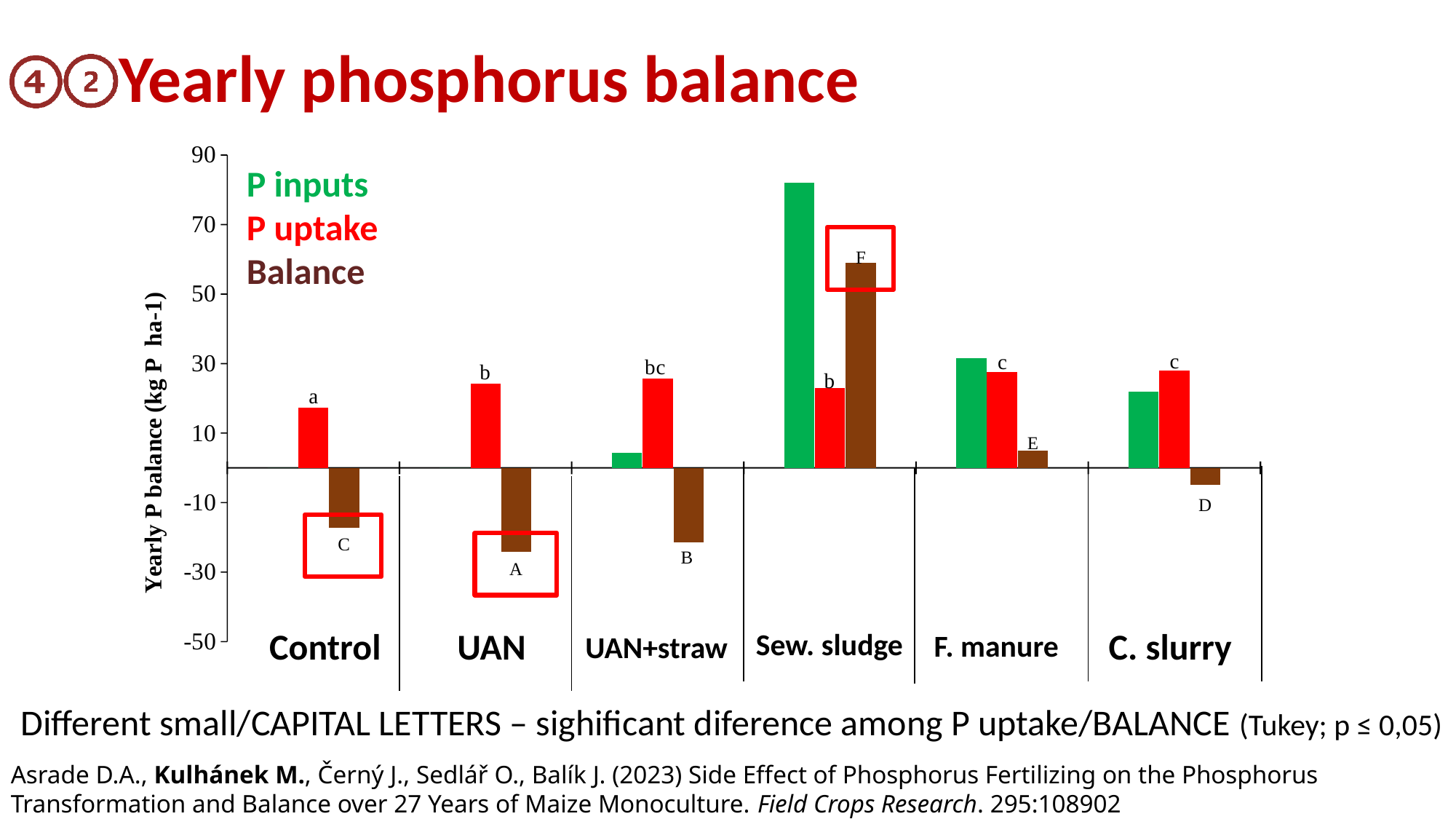
Which is larger, the P inputs for Sew. sludge or the P inputs for F. manure? Sew. sludge Which treatment has the highest P inputs? Sew. sludge How many treatment categories are shown on the x axis? 6 What kind of chart is shown on the slide? bar chart Is the Balance value for F. manure greater or less than 10? less What colour represents the Balance series? brown Is the Balance value for Sew. sludge greater or less than 50? greater Is the Balance value for Control greater or less than -10? less Which treatment has the highest Balance? Sew. sludge How many series does the legend list? 3 Which treatment has the lowest P uptake? Control